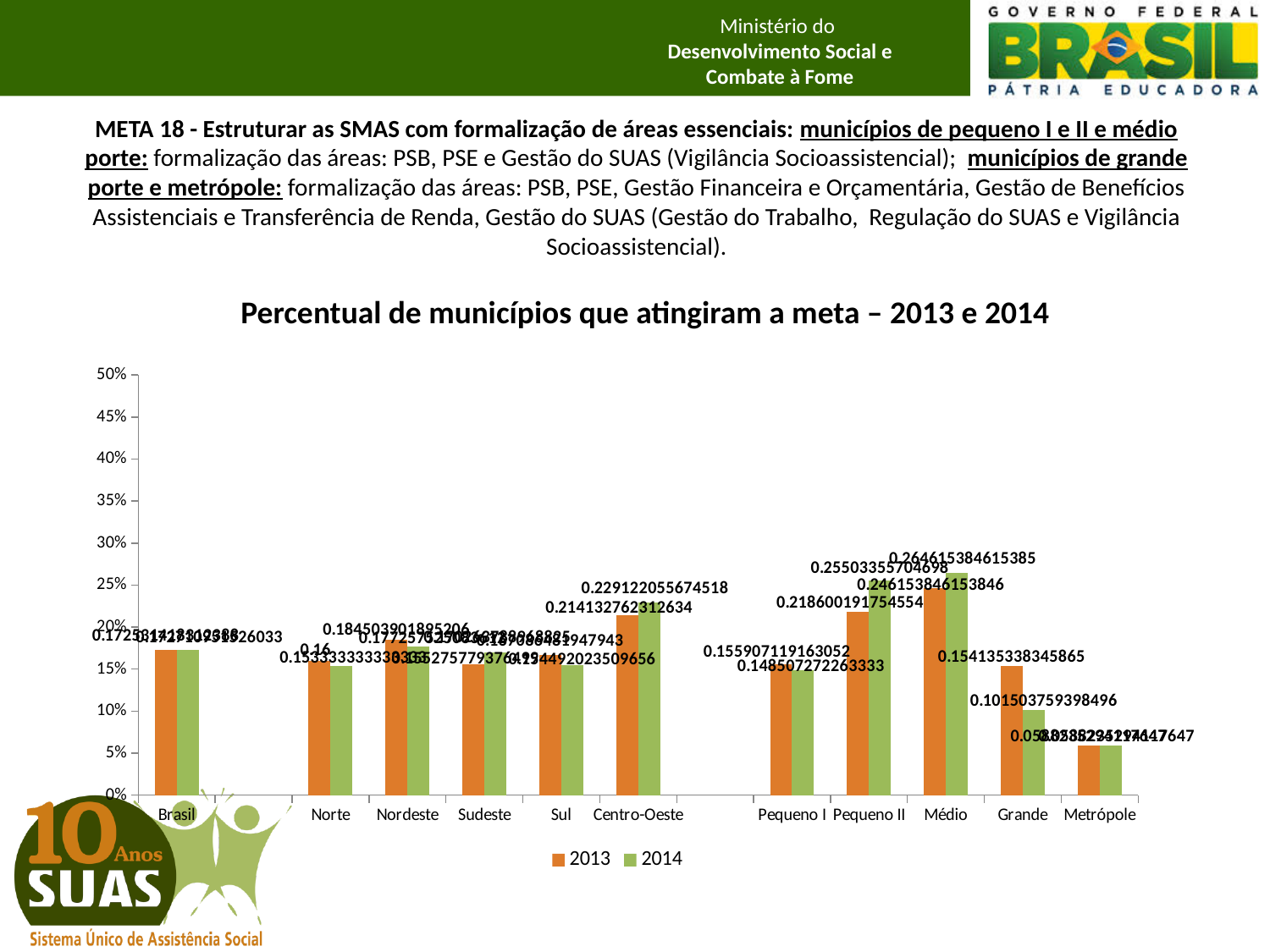
For Grande, which year has the larger value, 2013 or 2014? 2013 What is the value for Centro-Oeste in 2014? 0.229122055674518 How many series does the legend of the chart list? 2 What is the value for Médio in 2014? 0.264615384615385 Which category has the lowest value for 2013? Metrópole Is the value for Médio in 2013 greater or less than 20%? greater What is the value for Grande in 2013? 0.154135338345865 What are the two entries listed in the chart legend? 2013 and 2014 Which category has the highest value for 2014? Médio What is the value for Pequeno I in 2013? 0.155907119163052 What kind of chart is shown on the slide? bar chart How many categories are shown along the x axis of the chart? 11